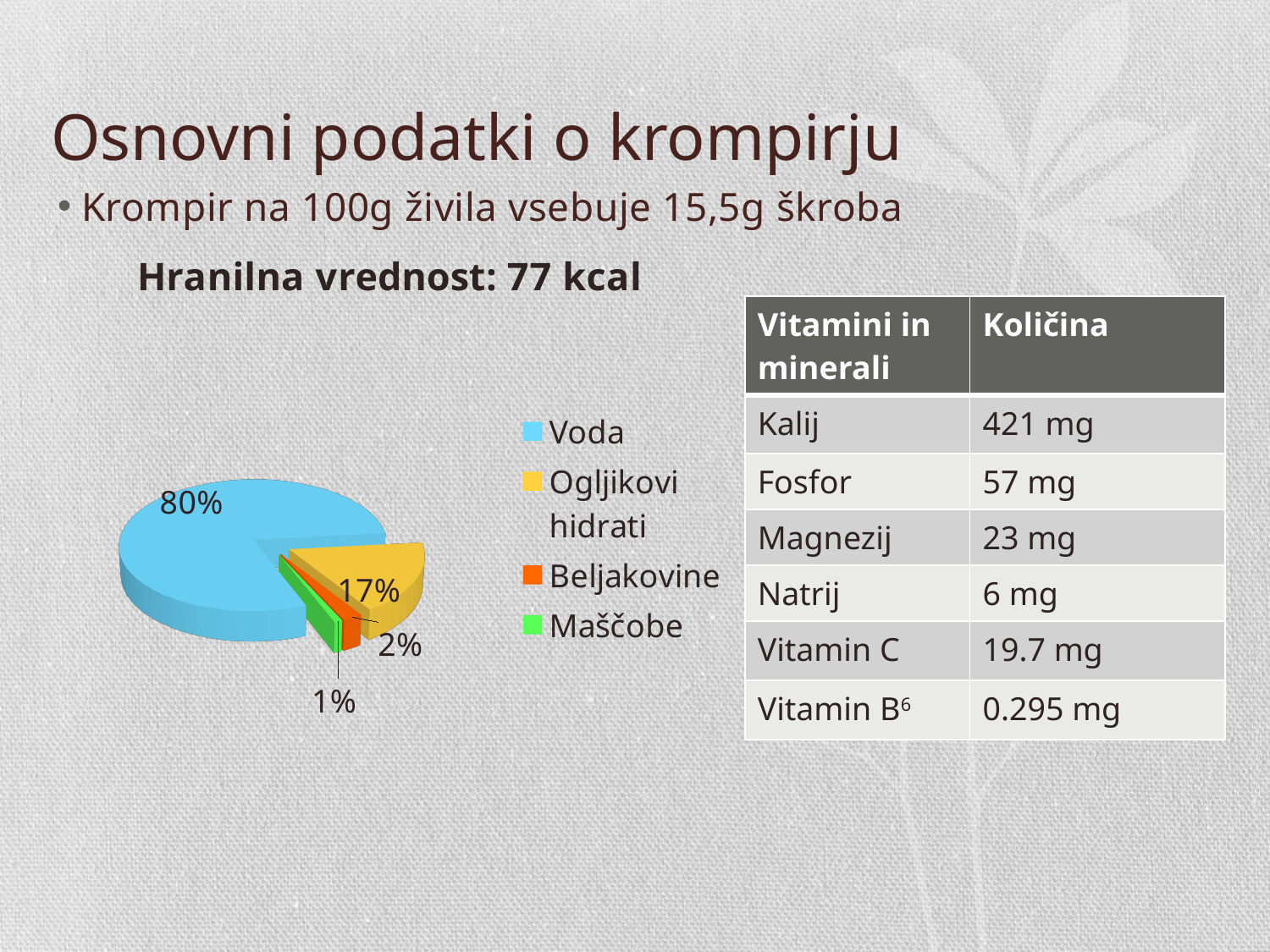
What share of the pie chart does Maščobe represent? 1% What share of the pie chart does Voda represent? 80% What is the difference in percentage points between Voda and Ogljikovi hidrati? 63 What type of chart is shown on the slide? Pie chart Which category has the smallest slice in the pie chart? Maščobe Which legend entry is shown in green? Maščobe Which category has the largest slice in the pie chart? Voda Which is larger in the pie chart, Beljakovine or Maščobe? Beljakovine What share of the pie chart does Ogljikovi hidrati represent? 17% How many categories does the pie chart show? 4 What colour is the Voda slice in the pie chart? Blue